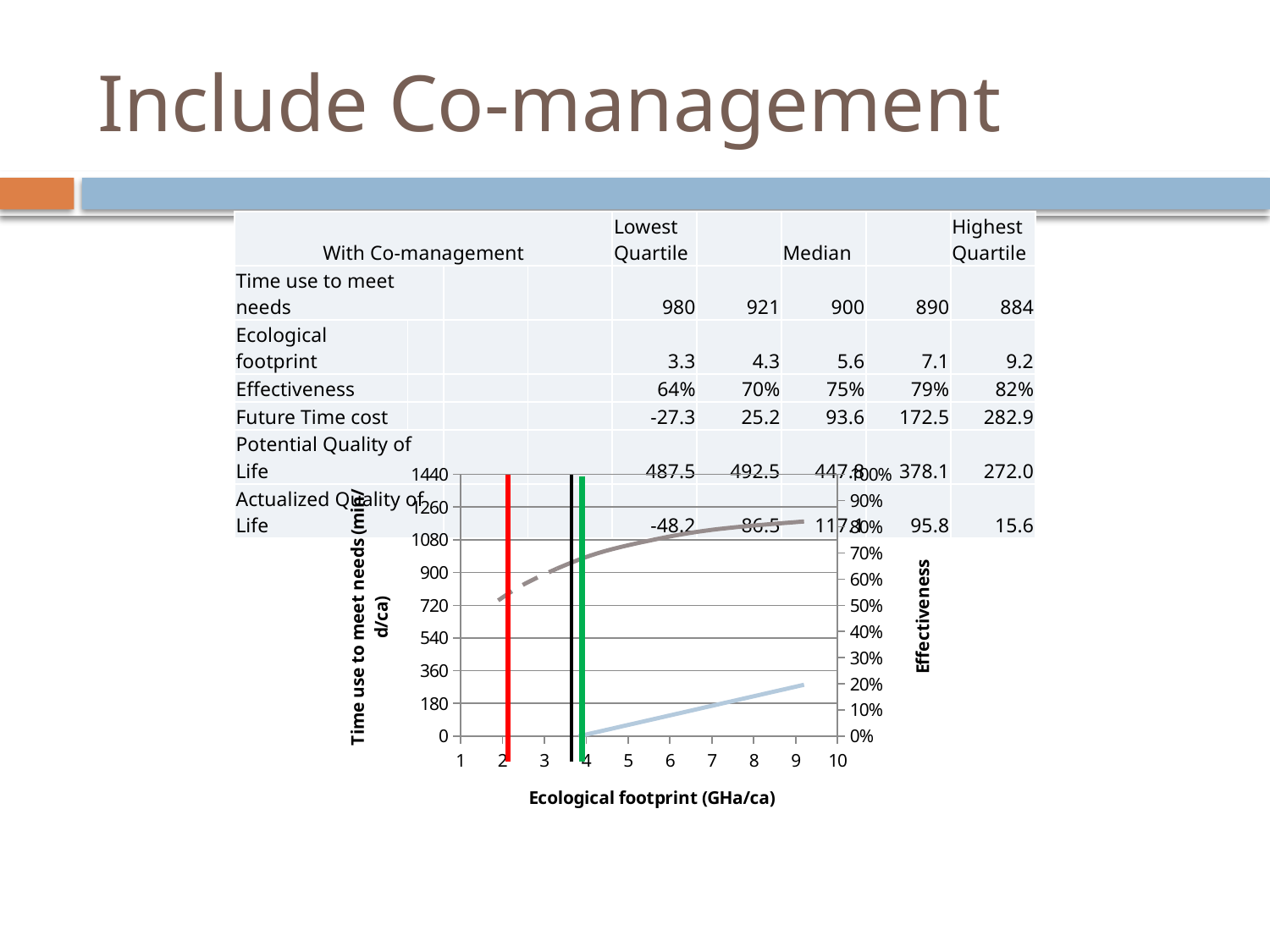
On the right-hand Effectiveness axis, is the dashed grey curve at an ecological footprint of 9 greater or less than 70%? greater What kind of chart is shown on the slide? line chart What is the highest tick value shown on the left y axis of the chart? 1440 On the left-hand axis, is the light blue line at an ecological footprint of 9 greater or less than 360? less What is the largest value shown on the x axis of the chart? 10 On the left-hand axis, is the light blue line at an ecological footprint of 9 greater or less than 180? greater What is the title of the right-hand y axis of the chart? Effectiveness How many vertical coloured marker lines are drawn on the chart? 3 What is the title of the x axis of the chart? Ecological footprint (GHa/ca) What is the highest tick value shown on the right y axis of the chart? 100% Does the light blue line rise or fall as the ecological footprint increases along the x axis? rise Does the dashed grey curve rise or fall as the ecological footprint increases along the x axis? rise